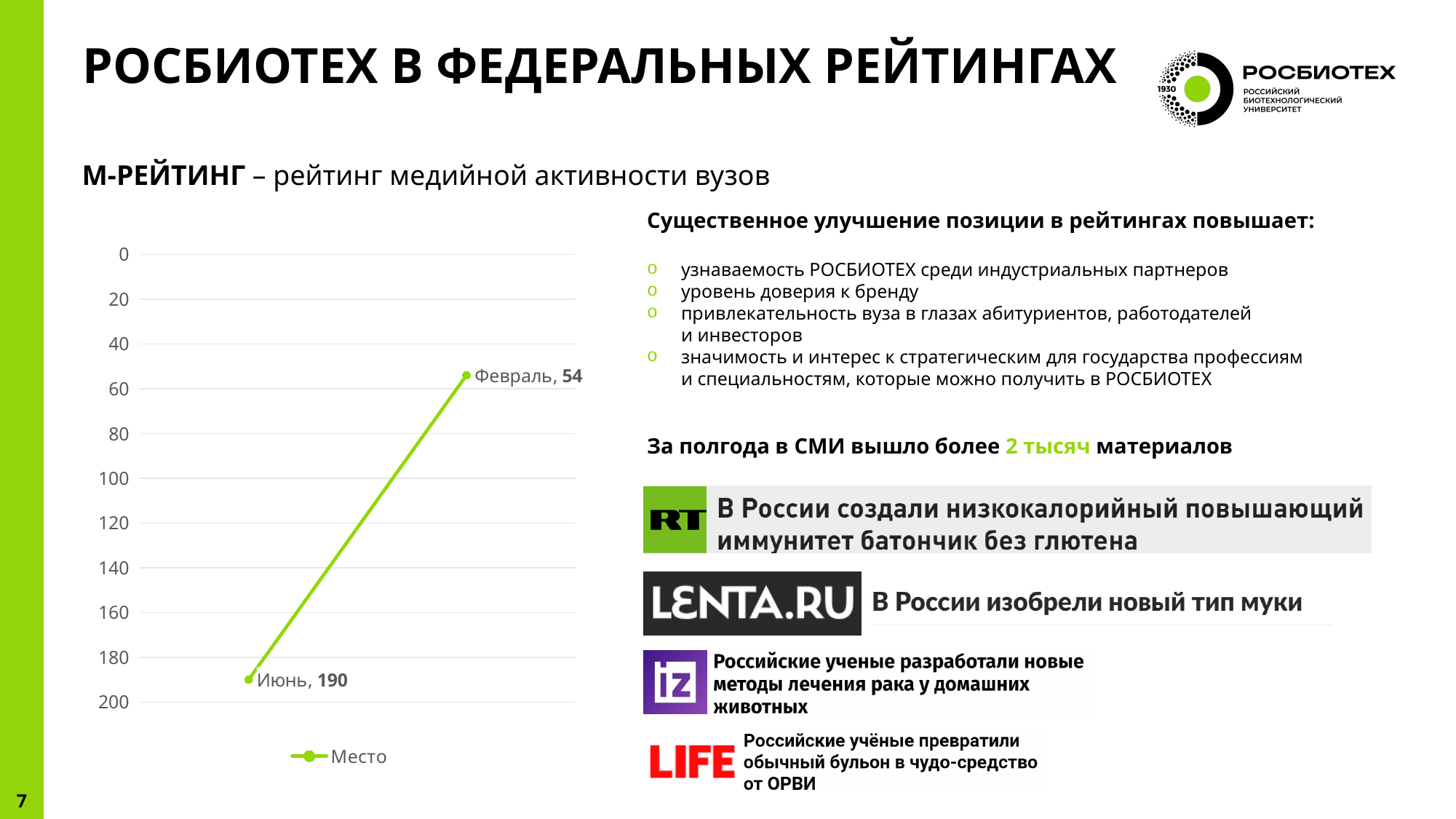
What is the name of the series shown in the chart legend? Место Is the value for Июнь greater or less than 160? greater How many series does the chart legend list? 1 What is the value for Июнь on the chart? 190 Which category has the highest value on the chart? Июнь Is the value for Февраль greater or less than 100? less Which category has the lowest value on the chart? Февраль What kind of chart is shown on the slide? line chart How many data points are plotted on the chart? 2 What is the difference between the values for Июнь and Февраль? 136 Which point has the higher value, Июнь or Февраль? Июнь What is the value for Февраль on the chart? 54